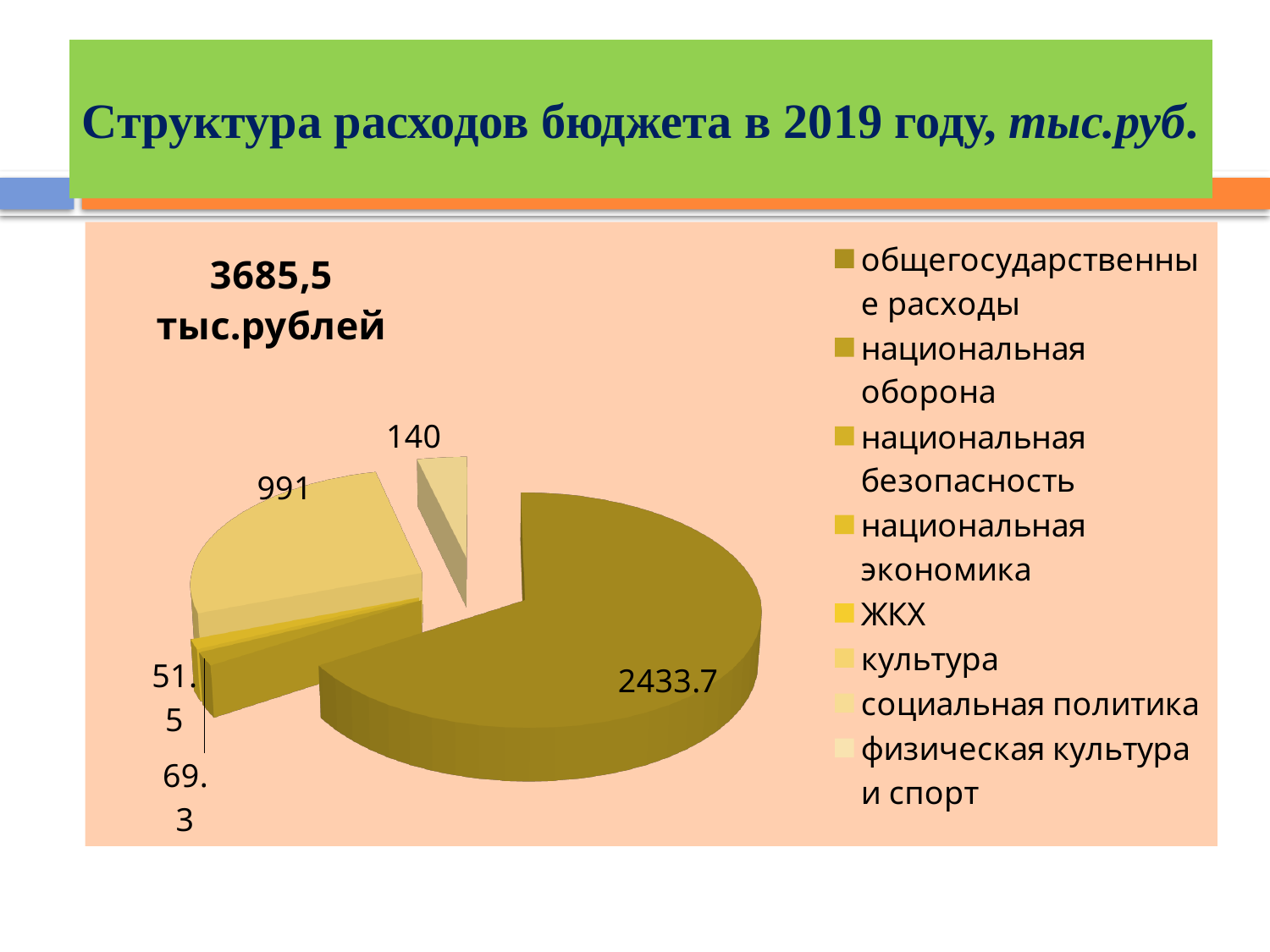
What is the smallest value labelled on the pie chart? 51.5 What total amount is printed above the pie chart? 3685,5 тыс.рублей What is the largest value labelled on the pie chart? 2433.7 What is the title of the slide? Структура расходов бюджета в 2019 году, тыс.руб. What kind of chart is shown on the slide? pie chart What is the difference between the slice labelled 140 and the slice labelled 69.3? 70.7 What is the last entry listed in the legend? физическая культура и спорт What is the difference between the slice labelled 2433.7 and the slice labelled 991? 1442.7 How many data labels are printed on the pie chart? 5 Which is larger, the slice labelled 140 or the slice labelled 69.3? 140 Which legend category corresponds to the largest slice of the pie? общегосударственные расходы How many entries does the legend list? 8